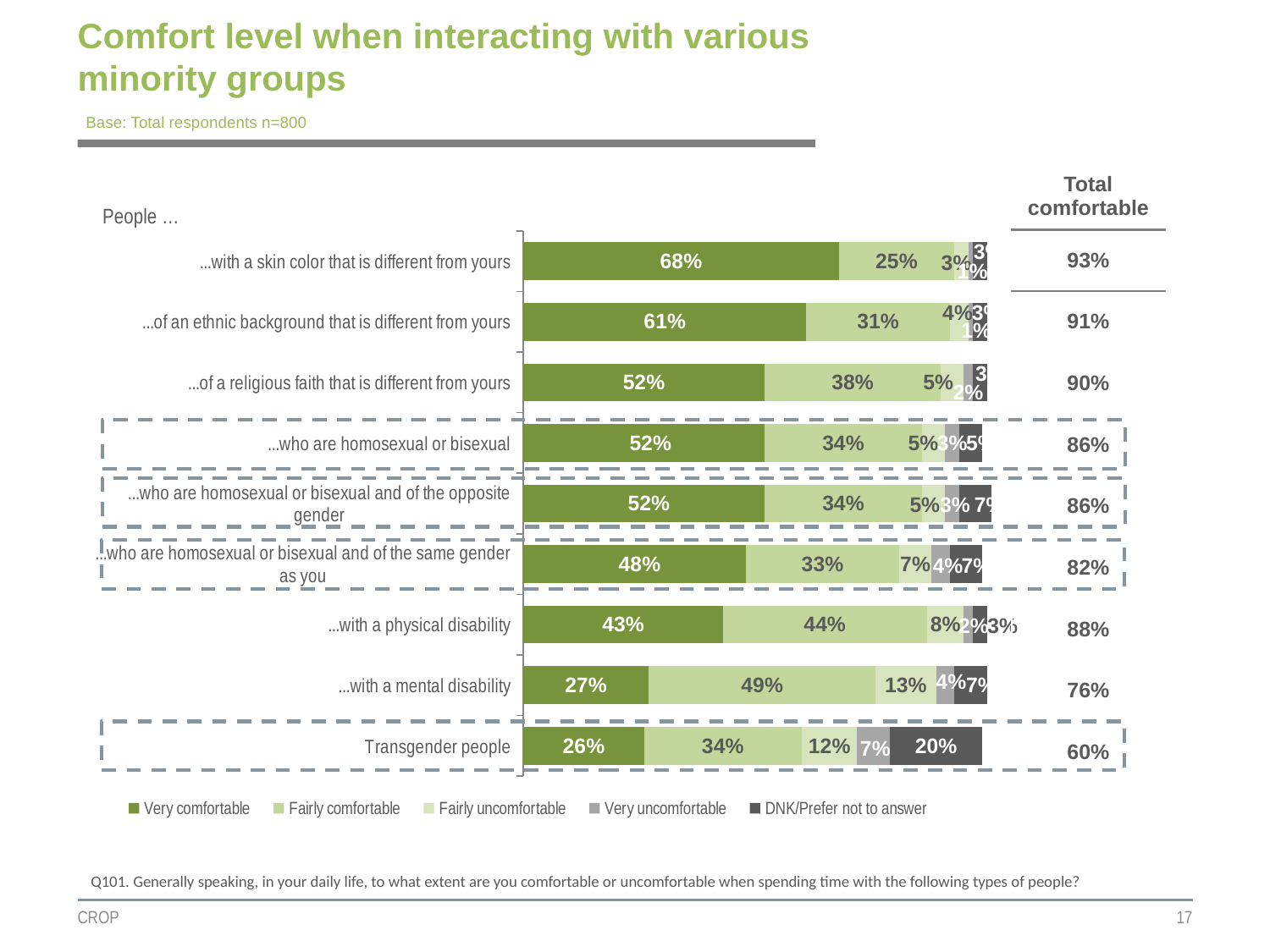
What is the difference between the 'Very comfortable' values for people with a skin color that is different from yours and people of a religious faith that is different from yours? 16% What type of chart is shown on the slide? Stacked bar chart What is the 'Fairly comfortable' value for people with a mental disability? 49% What is the 'Fairly uncomfortable' value for people with a mental disability? 13% What is the 'Total comfortable' figure shown for transgender people? 60% Which category has the lowest 'Very comfortable' value? Transgender people What is the 'DNK/Prefer not to answer' value for transgender people? 20% Which category has the highest 'Very comfortable' value? ...with a skin color that is different from yours How many categories of people are plotted in the chart? 9 Which is larger: the 'Fairly comfortable' value for people with a physical disability or for people with a mental disability? Mental disability (49%) How many series does the legend list? 5 What percentage of respondents are very comfortable with people with a skin color that is different from theirs? 68%